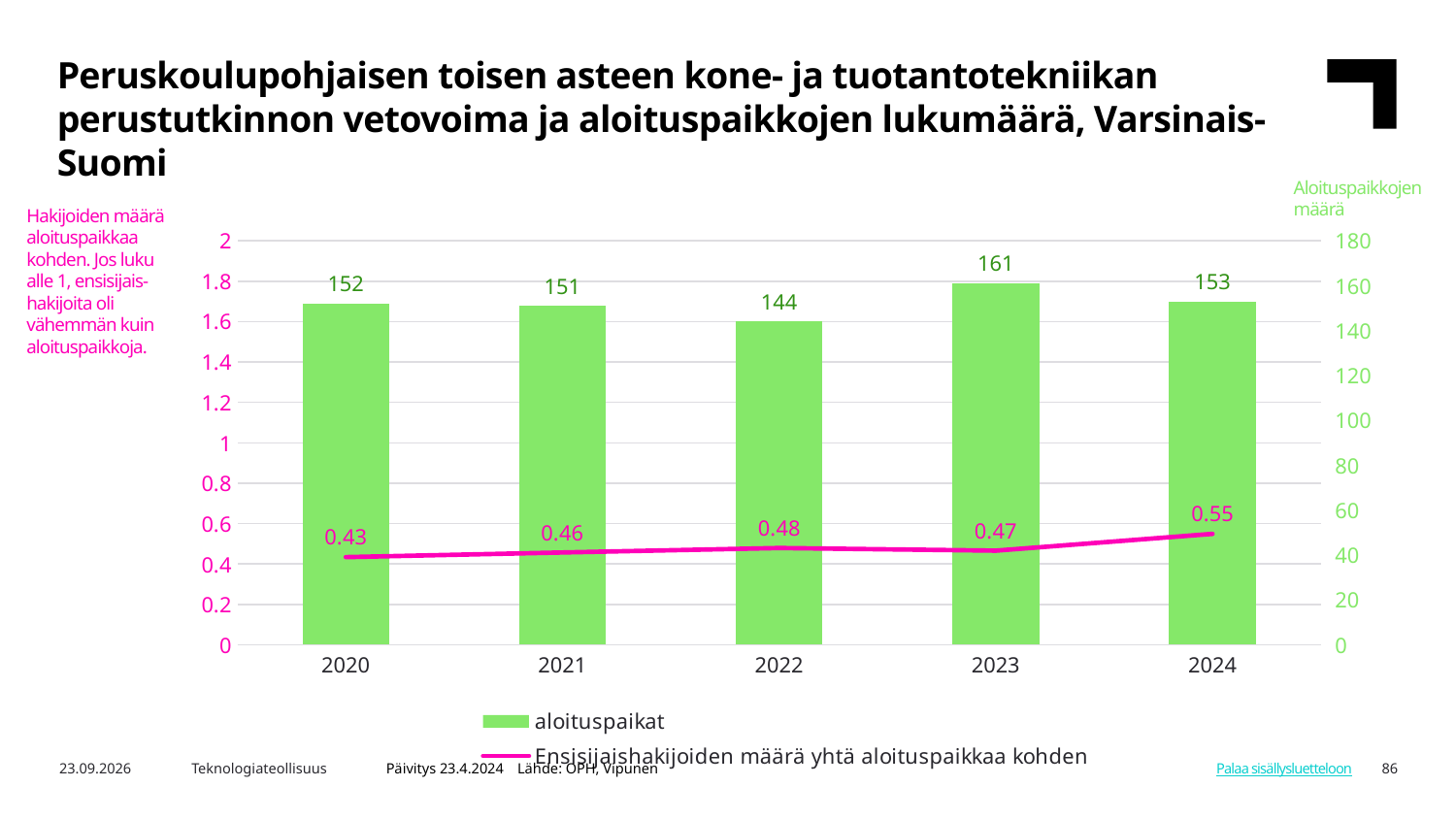
What is the value of Ensisijaishakijoiden määrä yhtä aloituspaikkaa kohden for 2024? 0.55 Which year has the highest value for aloituspaikat? 2023 What is the difference between the aloituspaikat values for 2023 and 2022? 17 What kind of chart is used for the aloituspaikat series? bar chart What colour is the line for Ensisijaishakijoiden määrä yhtä aloituspaikkaa kohden? pink Which year has the lowest value for Ensisijaishakijoiden määrä yhtä aloituspaikkaa kohden? 2020 What is the value of aloituspaikat for 2023? 161 Is the aloituspaikat value for 2021 greater or less than 140? greater Which is larger, the aloituspaikat value for 2020 or for 2024? 2024 How many series does the legend list? 2 What is the value of aloituspaikat for 2022? 144 How many years are shown on the x axis? 5